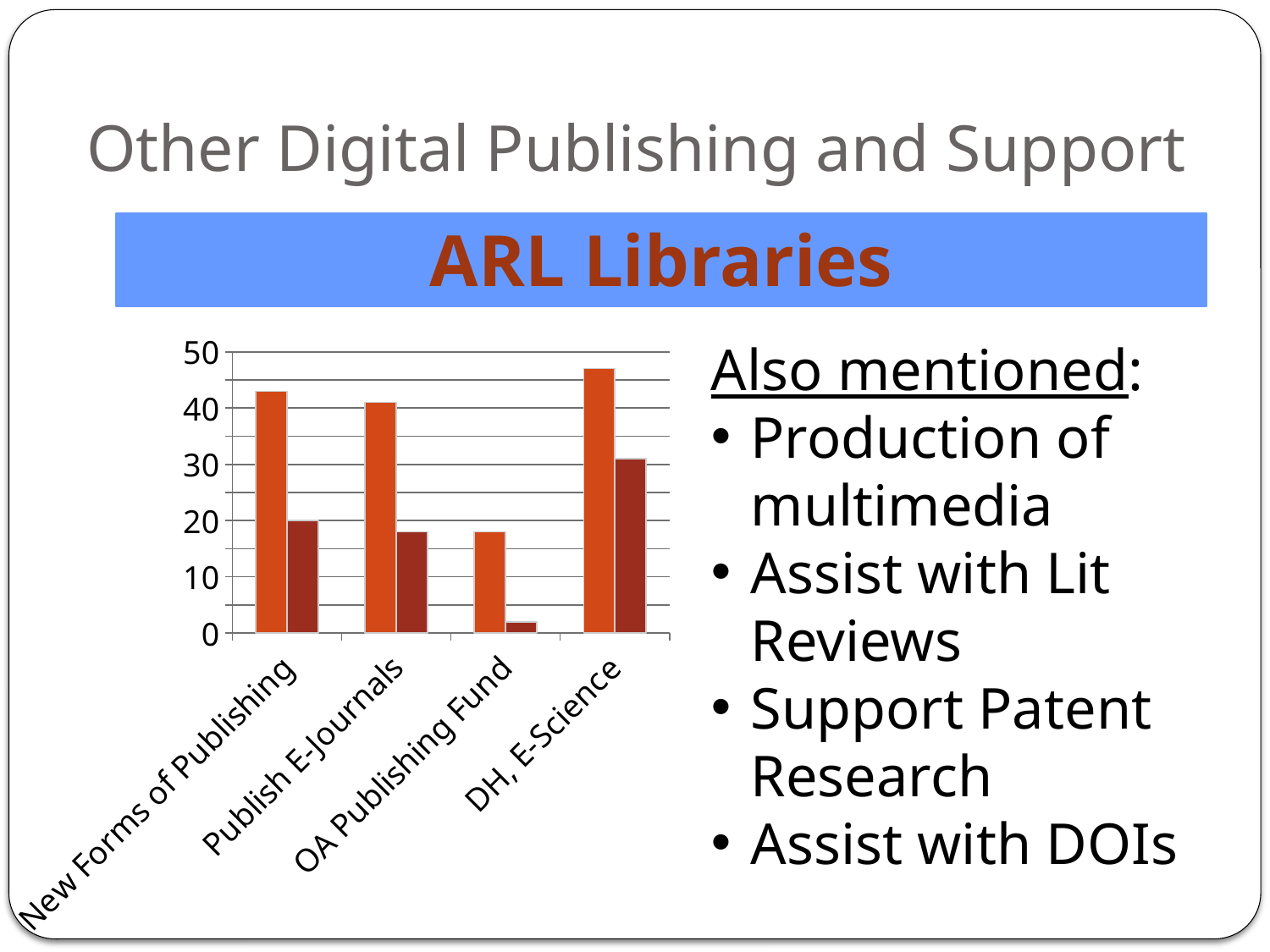
Is the dark red bar for OA Publishing Fund greater or less than 10? less Is the orange bar for New Forms of Publishing greater or less than 40? greater Is the orange bar for OA Publishing Fund greater or less than 30? less Which category has the tallest dark red bar? DH, E-Science How many categories are shown on the x axis of the chart? 4 Which category has the tallest orange bar? DH, E-Science Which category has the shortest orange bar? OA Publishing Fund Which category has the shortest dark red bar? OA Publishing Fund What kind of chart is shown on the slide? bar chart What is the title shown in the blue banner above the chart? ARL Libraries For New Forms of Publishing, which bar is taller, the orange one or the dark red one? the orange one